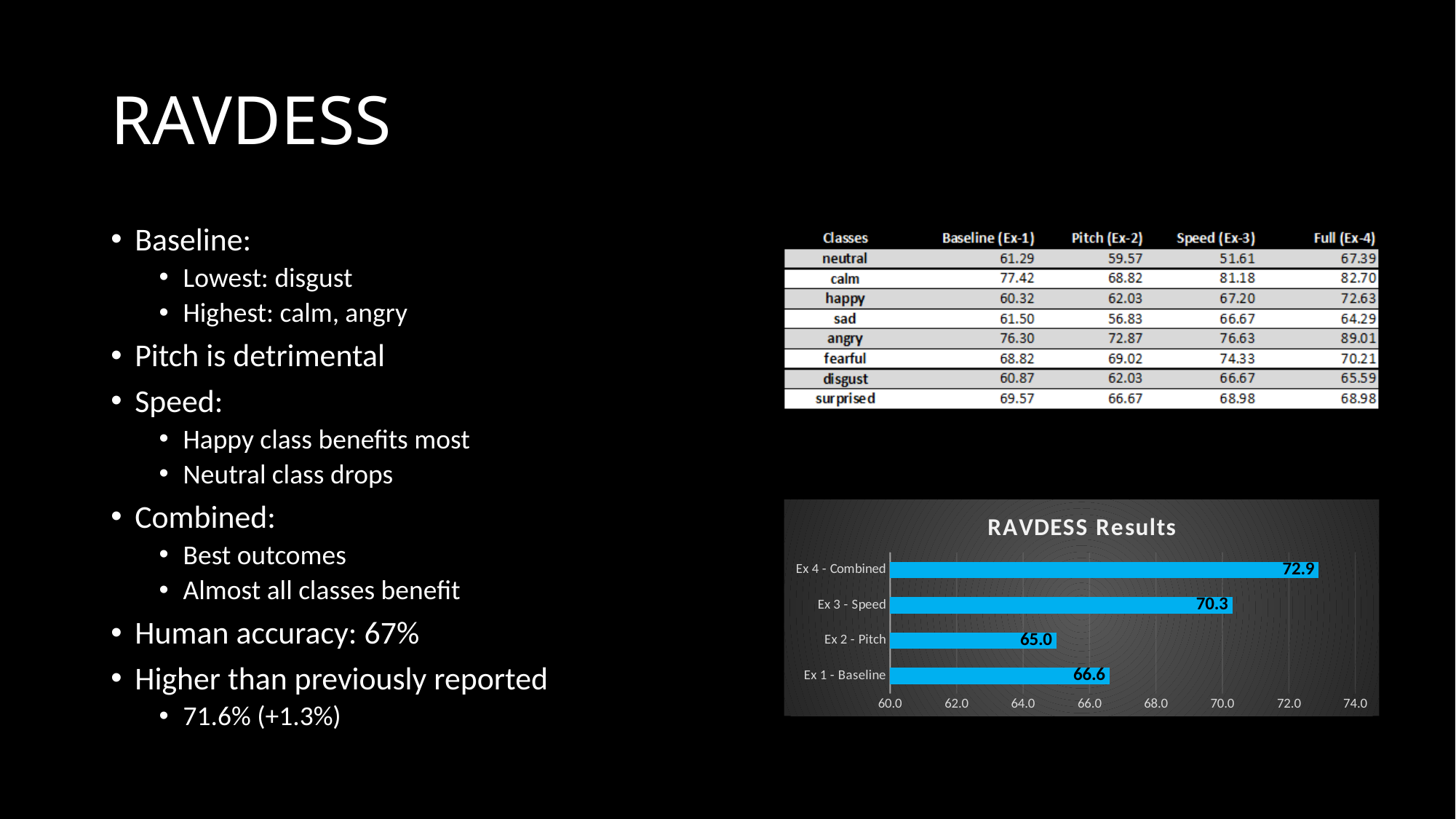
Which category has the highest value in the RAVDESS Results chart? Ex 4 - Combined What is the difference between the values for Ex 4 - Combined and Ex 1 - Baseline in the RAVDESS Results chart? 6.3 In the RAVDESS Results chart, which is larger: the value for Ex 3 - Speed or the value for Ex 1 - Baseline? Ex 3 - Speed What is the difference between the values for Ex 1 - Baseline and Ex 2 - Pitch in the RAVDESS Results chart? 1.6 Is the value for Ex 3 - Speed in the RAVDESS Results chart greater or less than 68.0? greater What is the value for Ex 1 - Baseline in the RAVDESS Results chart? 66.6 How many categories are shown in the RAVDESS Results chart? 4 What is the value for Ex 2 - Pitch in the RAVDESS Results chart? 65.0 What kind of chart is the RAVDESS Results chart? bar chart What is the value for Ex 4 - Combined in the RAVDESS Results chart? 72.9 Which category has the lowest value in the RAVDESS Results chart? Ex 2 - Pitch What is the value for Ex 3 - Speed in the RAVDESS Results chart? 70.3